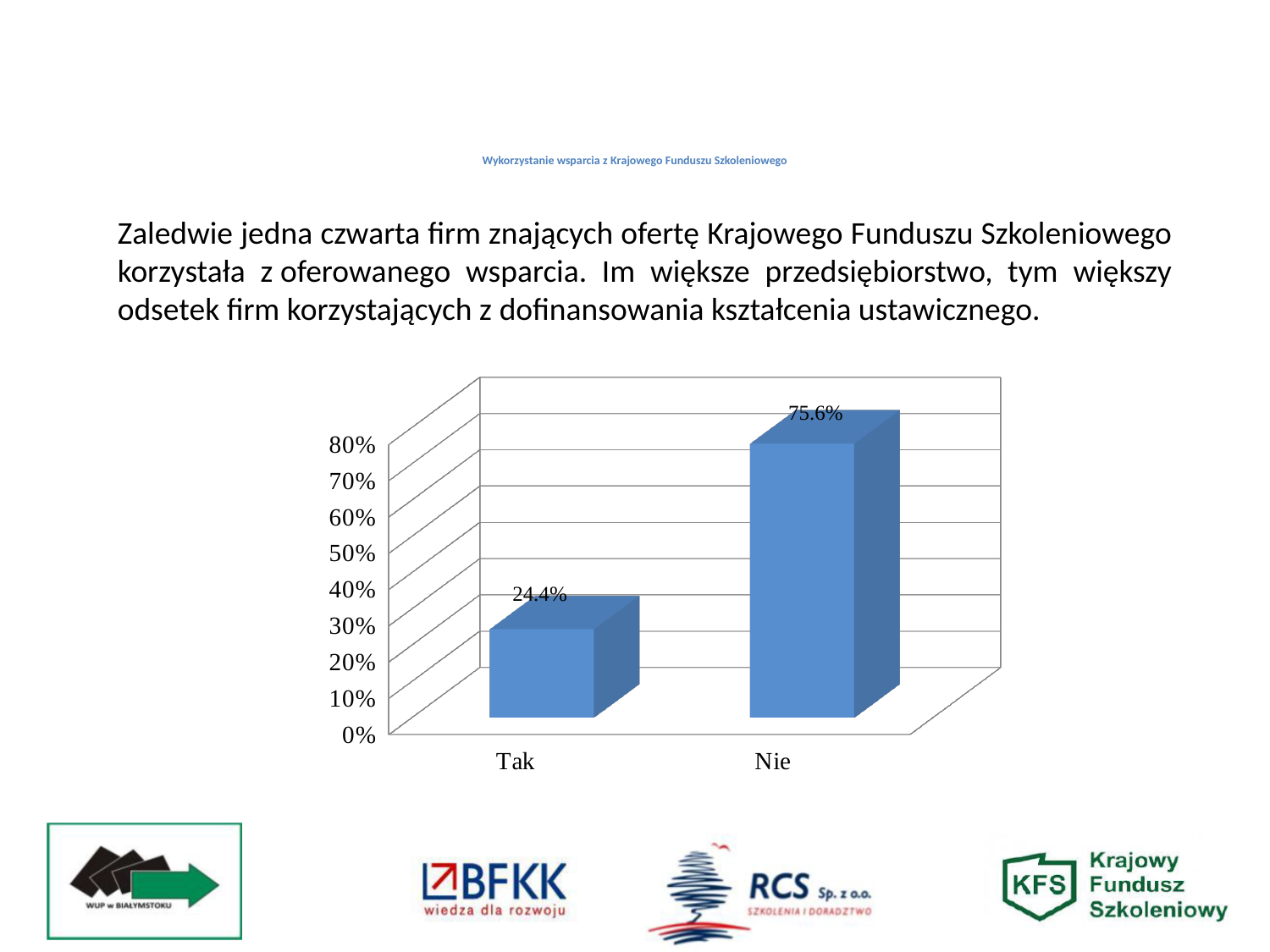
What kind of chart is shown on the slide? bar chart What is the difference between the values for "Nie" and "Tak"? 51.2% What is the value for "Tak"? 24.4% Is the value for "Nie" greater or less than 70%? greater Is the value for "Tak" greater or less than 30%? less Which category has the highest value? Nie Which category has the lowest value? Tak How many categories are shown on the chart? 2 What is the total of the two values shown on the chart? 100% Which is larger, the value for "Tak" or the value for "Nie"? Nie What is the value for "Nie"? 75.6% What is the highest value shown on the vertical axis of the chart? 80%